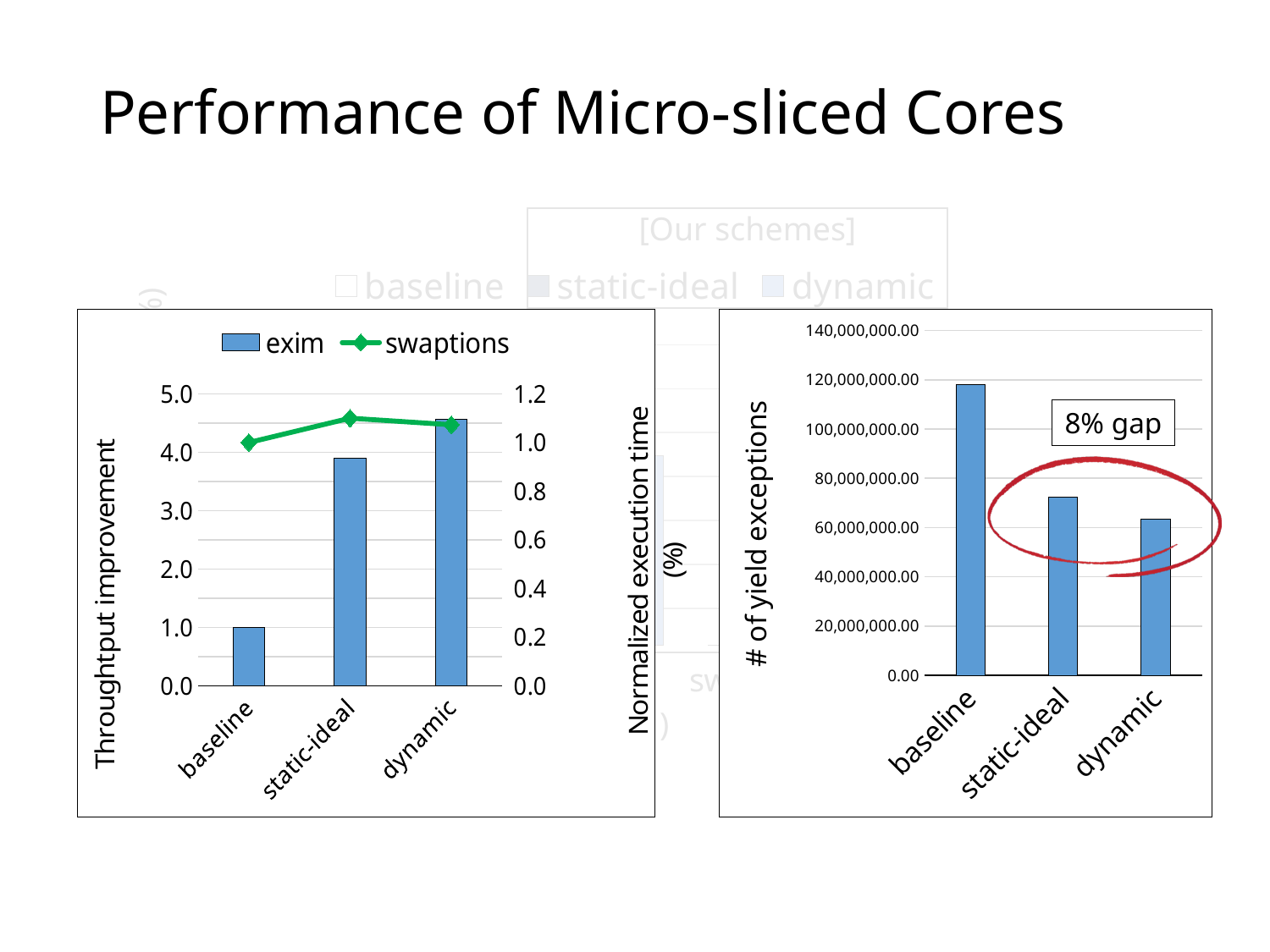
On the right chart (# of yield exceptions), is the value for baseline greater or less than 100,000,000.00? greater On the left chart, which series is drawn as a line with diamond markers? swaptions On the left chart, is the exim throughput improvement for static-ideal greater or less than 3.0? greater On the right chart (# of yield exceptions), which category has the highest number of yield exceptions? baseline On the left chart, how many series does the legend list? 2 On the left chart, which category has the highest exim throughput improvement? dynamic On the right chart (# of yield exceptions), which category has the lowest number of yield exceptions? dynamic On the right chart (# of yield exceptions), is the value for static-ideal greater or less than 80,000,000.00? less On the right chart (# of yield exceptions), what gap is annotated between the static-ideal and dynamic bars? 8% gap On the left chart, how many categories are shown on the x axis? 3 On the left chart, which category has the lowest exim throughput improvement? baseline